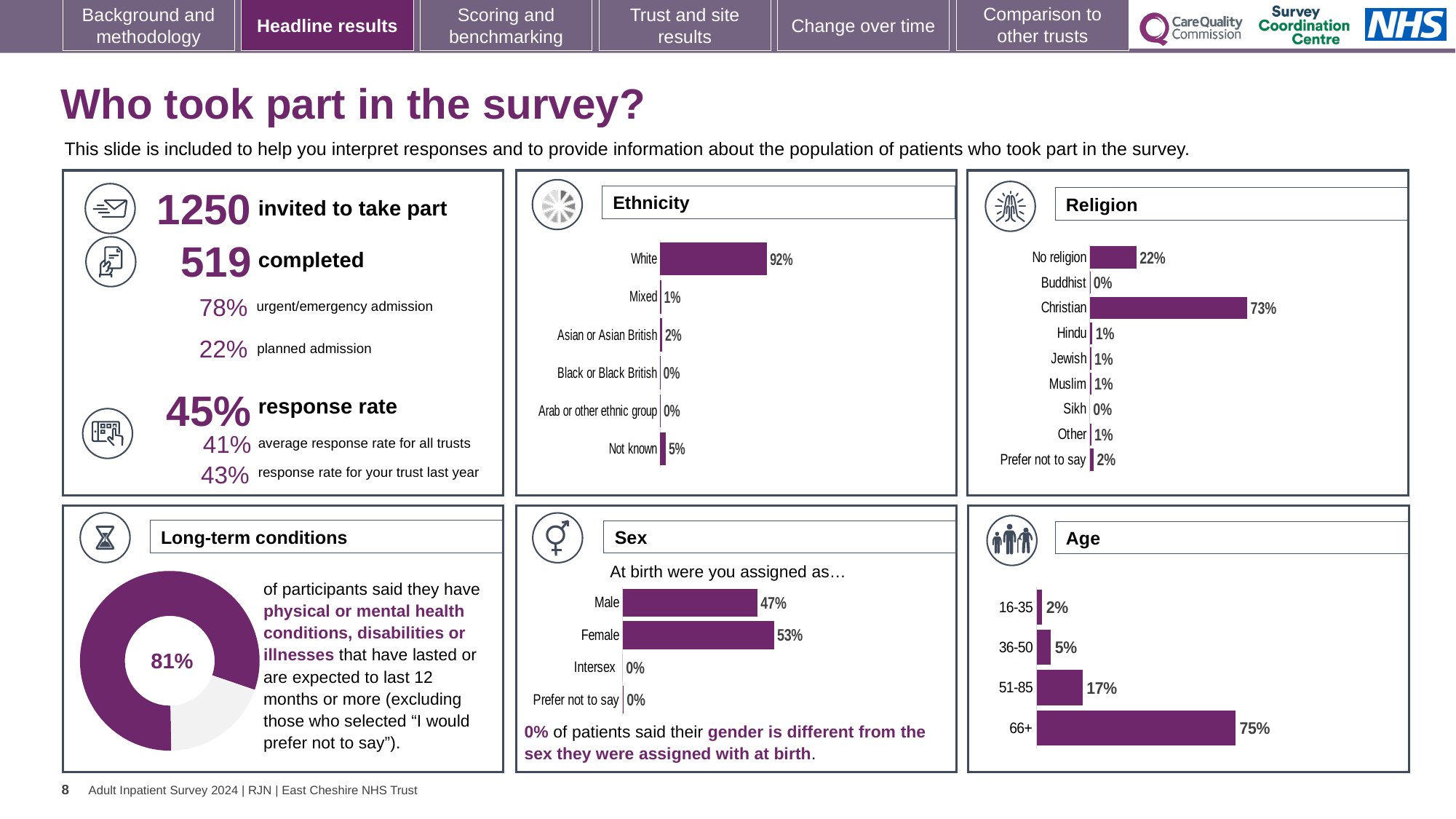
In the Ethnicity chart, what percentage of participants were White? 92% In the Sex chart, what is the value for Male? 47% In the Sex chart, which is larger, Male or Female? Female How many categories are shown in the Religion chart? 9 In the Age chart, what is the difference between the 66+ and 51-85 values? 58% In the Religion chart, which category has the highest value? Christian In the Ethnicity chart, what is the value for Not known? 5% In the Age chart, do the values rise or fall from 16-35 to 66+? Rise What kind of chart is the Long-term conditions chart? Doughnut chart In the Religion chart, what is the value for No religion? 22% In the Long-term conditions chart, what share of participants said they have long-term conditions? 81% How many categories are shown in the Ethnicity chart? 6